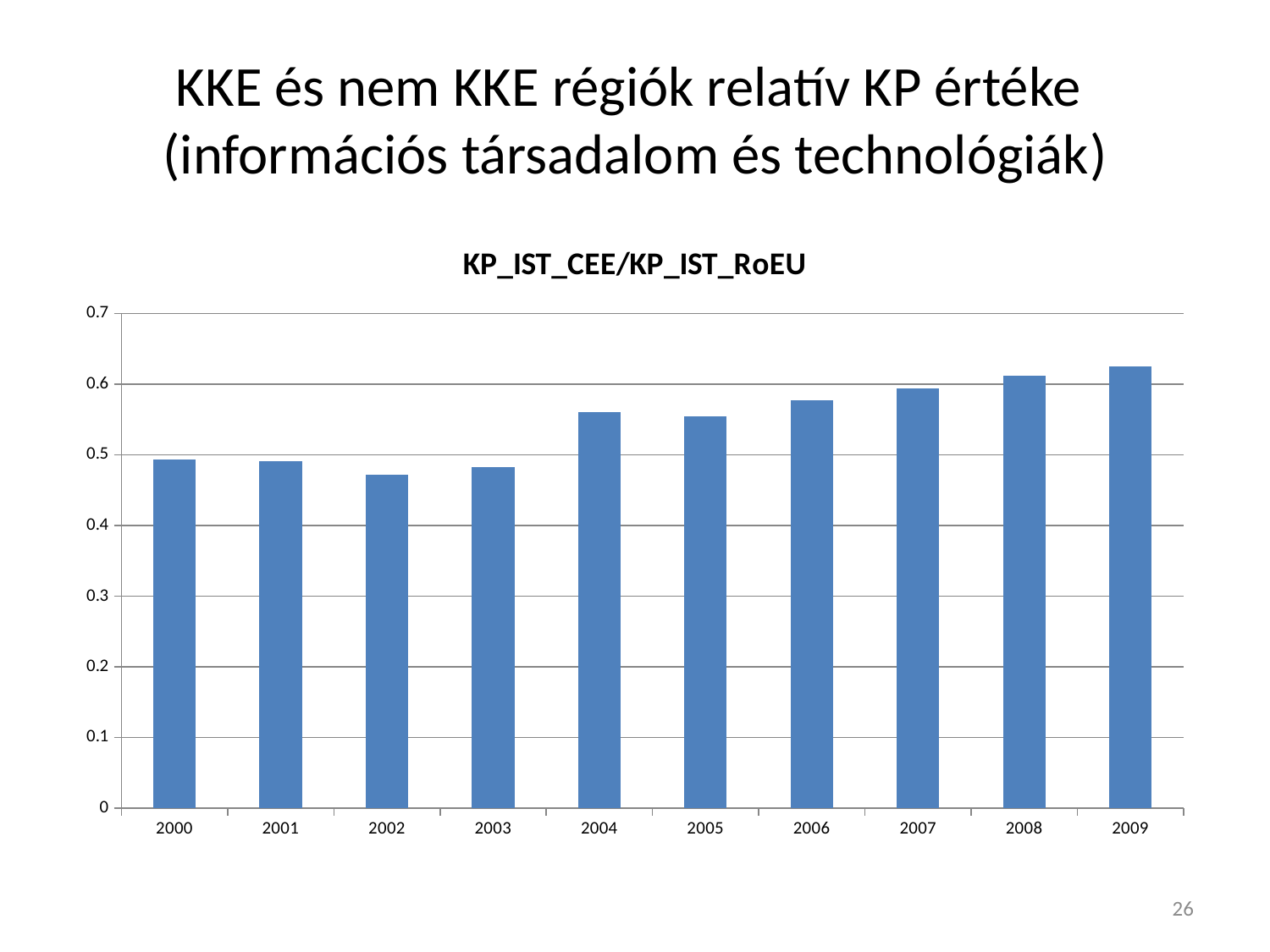
How many years are shown on the x axis of the chart? 10 What is the title of the chart? KP_IST_CEE/KP_IST_RoEU Is the value for 2002 greater or less than 0.5? less Is the value for 2004 greater or less than 0.5? greater Is the value for 2006 greater or less than 0.6? less Which is larger, the value for 2000 or the value for 2009? 2009 Which year has the highest value in the chart? 2009 What kind of chart is shown on the slide? bar chart Which is larger, the value for 2003 or the value for 2004? 2004 Do the values generally rise or fall from 2000 to 2009? rise Which year has the lowest value in the chart? 2002